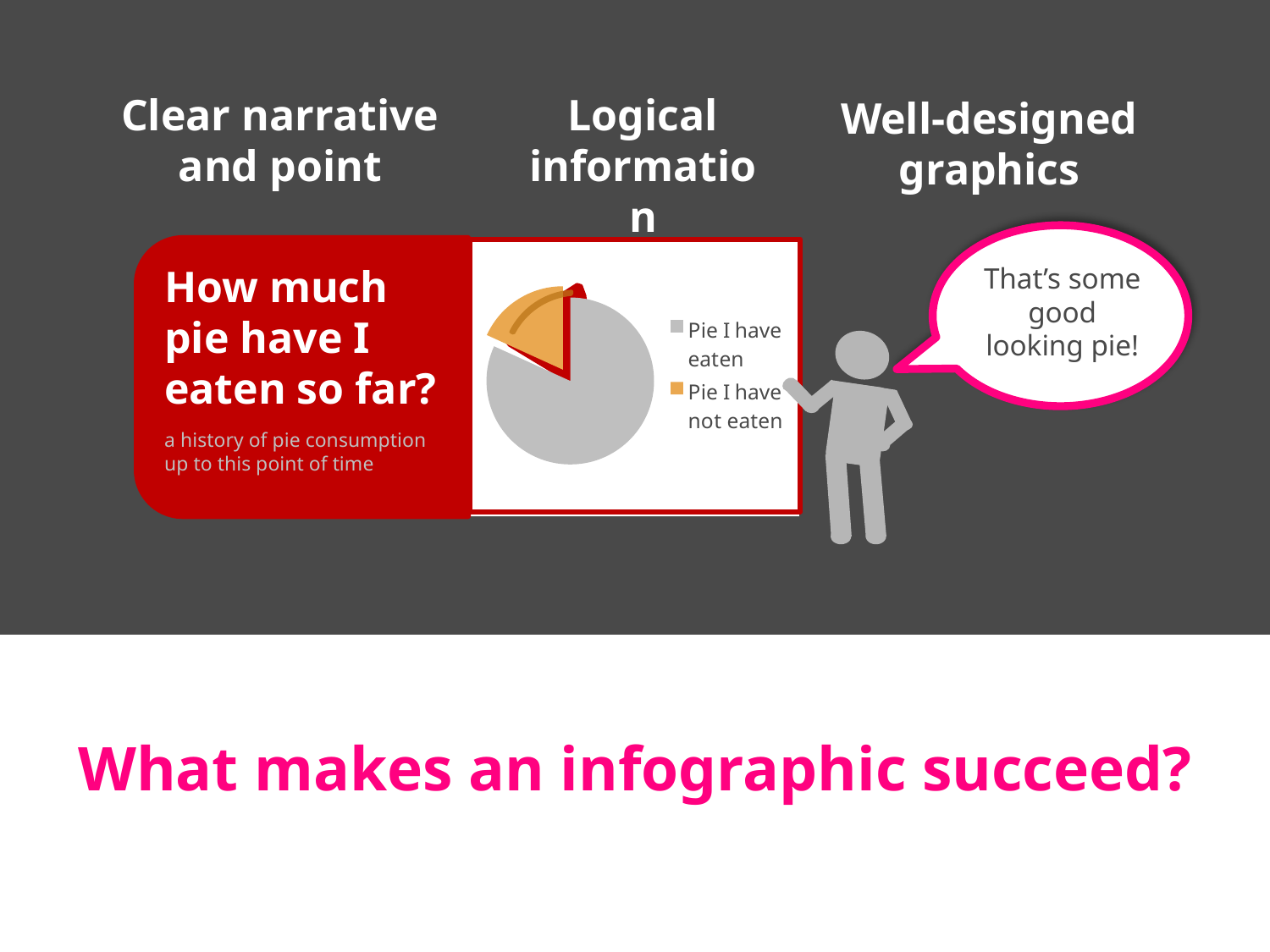
Which slice of the pie chart is the smallest? Pie I have not eaten Which slice of the pie chart is the largest? Pie I have eaten What are the two legend entries of the pie chart? Pie I have eaten; Pie I have not eaten In the pie chart, which is larger: "Pie I have eaten" or "Pie I have not eaten"? Pie I have eaten How many entries does the pie chart's legend list? 2 What colour is the "Pie I have not eaten" slice in the pie chart? orange What kind of chart is shown on the slide? pie chart How many slices does the pie chart have? 2